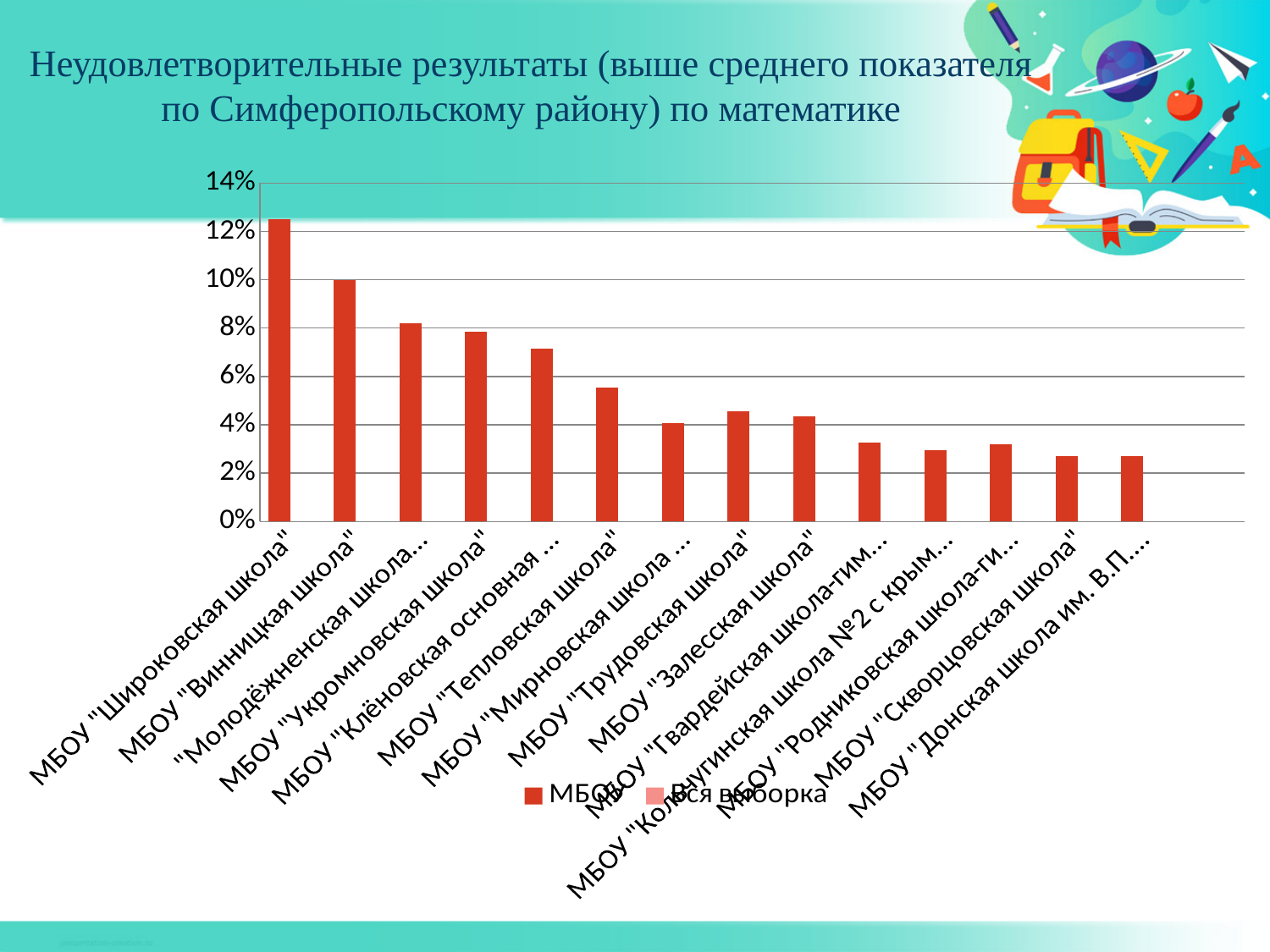
Is the value for МБОУ "Укромновская школа" greater or less than 6%? greater Is the value for МБОУ "Широковская школа" greater or less than 10%? greater How many series does the legend list? 2 Do the values generally rise or fall from left to right along the x axis? fall What are the two entries listed in the chart legend? МБОУ and Вся выборка Which school has the highest value in the chart? МБОУ "Широковская школа" Is the value for МБОУ "Тепловская школа" greater or less than 4%? greater Which is larger, the value for МБОУ "Широковская школа" or МБОУ "Винницкая школа"? МБОУ "Широковская школа" What kind of chart is shown on the slide? bar chart Which is larger, the value for МБОУ "Тепловская школа" or МБОУ "Залесская школа"? МБОУ "Тепловская школа" How many schools (bars) are shown in the chart? 14